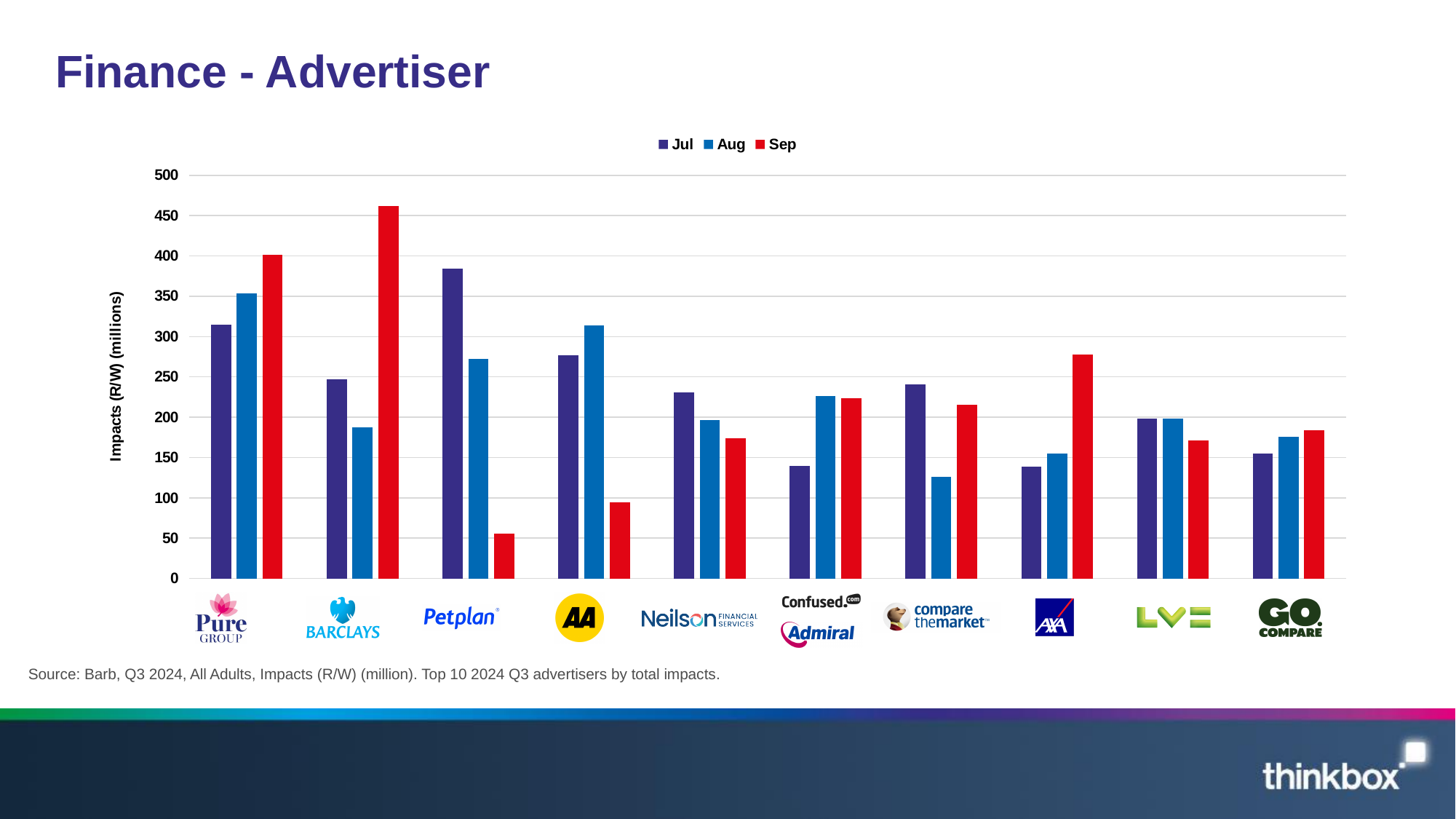
Which is larger for AA: the Aug value or the Sep value? Aug What is the label on the y axis? Impacts (R/W) (millions) Do the values for Petplan rise or fall from Jul to Sep? fall Which advertiser has the highest Sep bar? Barclays What kind of chart is shown on the slide? bar chart How many advertisers are shown along the x axis? 10 Is the Sep value for Barclays greater or less than 450? greater How many series does the legend list? 3 Which advertiser has the highest Jul bar? Petplan Is the Jul value for Pure Group greater or less than 300? greater Is the Sep value for Petplan greater or less than 100? less Which advertiser has the lowest Sep bar? Petplan